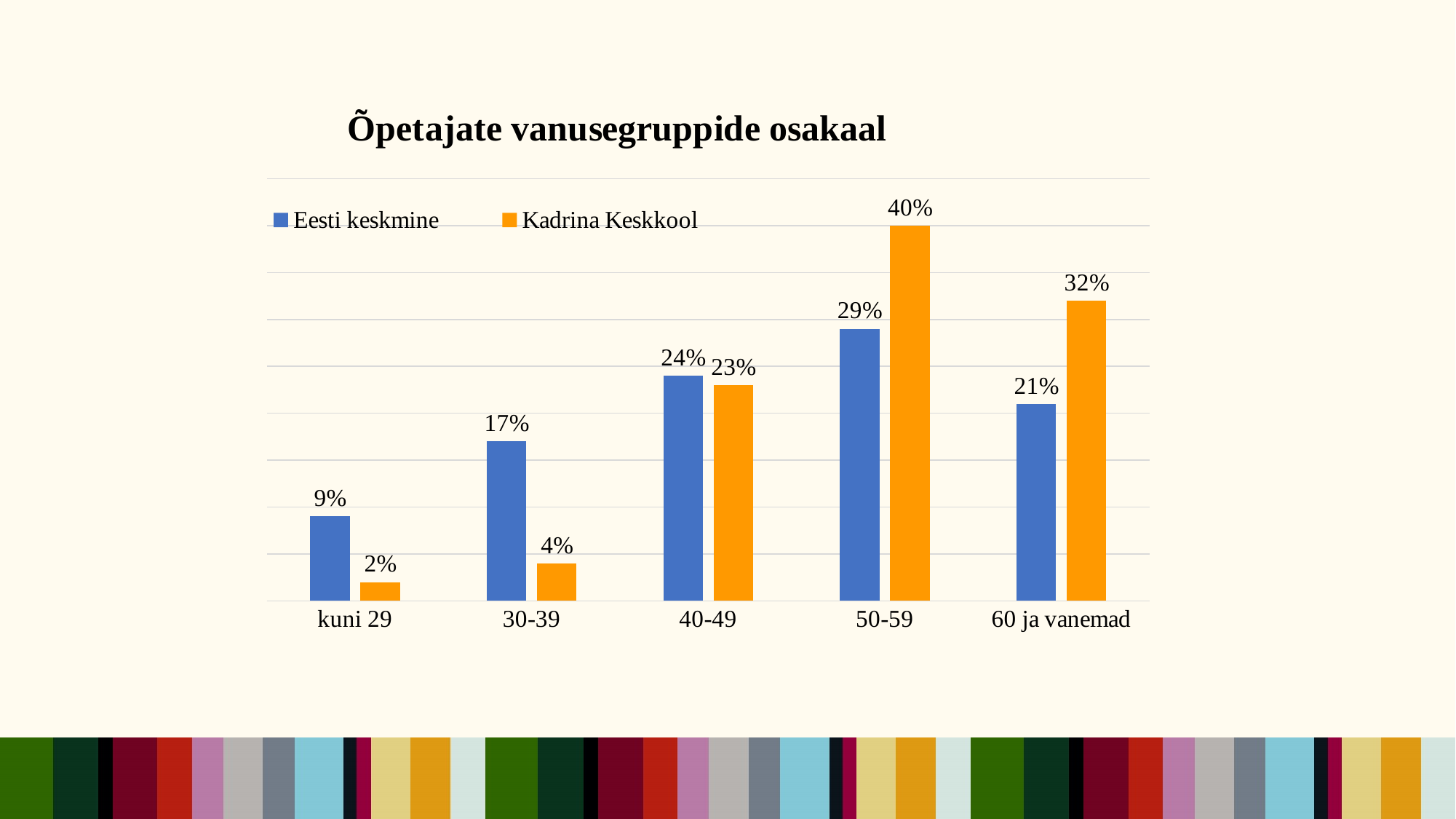
What is the Kadrina Keskkool value for the 50-59 age group? 40% Which age group has the lowest Eesti keskmine value? kuni 29 What is the difference between the Kadrina Keskkool and Eesti keskmine values for the 60 ja vanemad age group? 11% What kind of chart is shown on the slide? Bar chart Do the Eesti keskmine values rise or fall from kuni 29 to 50-59? Rise For the 40-49 age group, which series has the larger value, Eesti keskmine or Kadrina Keskkool? Eesti keskmine Which age group has the highest Kadrina Keskkool value? 50-59 How many age groups are shown on the x axis? 5 How many series does the legend list? 2 What is the title of the chart? Õpetajate vanusegruppide osakaal What is the Eesti keskmine value for the 30-39 age group? 17% What is the Kadrina Keskkool value for the kuni 29 age group? 2%